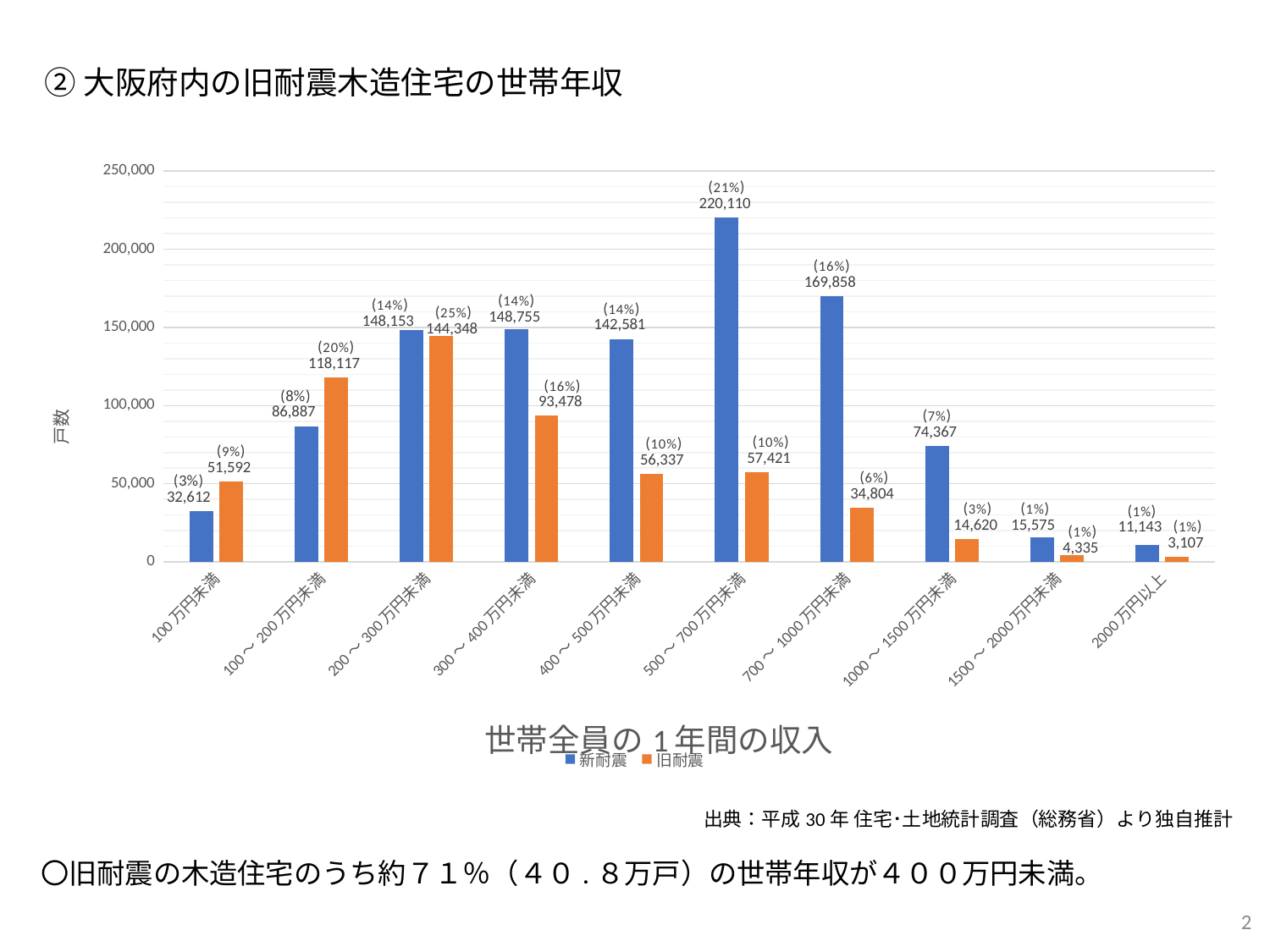
What percentage is shown above the 旧耐震 bar for 100～200万円未満? 20% How many series does the legend list? 2 What is the label on the y axis of the chart? 戸数 How many income categories are shown on the x axis? 10 What is the value for 新耐震 in the 500～700万円未満 category? 220,110 Which income category has the lowest 旧耐震 value? 2000万円以上 What is the value for 旧耐震 in the 200～300万円未満 category? 144,348 What is the difference between the 新耐震 and 旧耐震 values in the 700～1000万円未満 category? 135,054 Which income category has the highest 新耐震 value? 500～700万円未満 In the 100万円未満 category, which series has the larger value, 新耐震 or 旧耐震? 旧耐震 What kind of chart is shown on the slide? Bar chart Is the 新耐震 value for 1000～1500万円未満 greater or less than 100,000? less